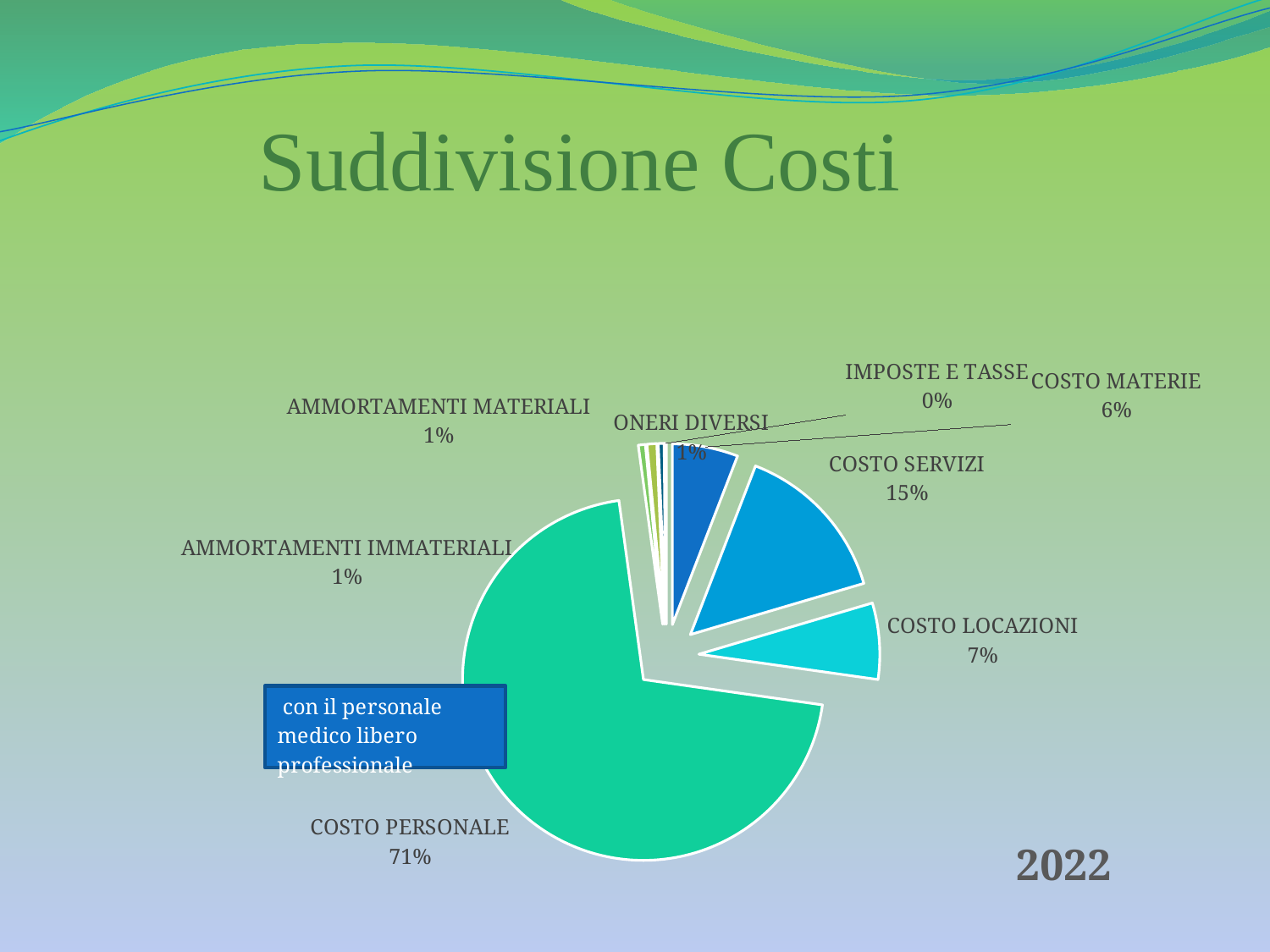
What share of costs is COSTO SERVIZI? 15% What share of costs is COSTO LOCAZIONI? 7% Which category has the largest share of the pie? COSTO PERSONALE Which category has the smallest share of the pie? IMPOSTE E TASSE What share of costs is COSTO MATERIE? 6% What is the difference in percentage points between COSTO PERSONALE and COSTO SERVIZI? 56 What kind of chart is shown on the slide? pie chart Which is larger, COSTO LOCAZIONI or COSTO MATERIE? COSTO LOCAZIONI What is the title of the slide containing the chart? Suddivisione Costi How many categories are shown in the pie chart? 8